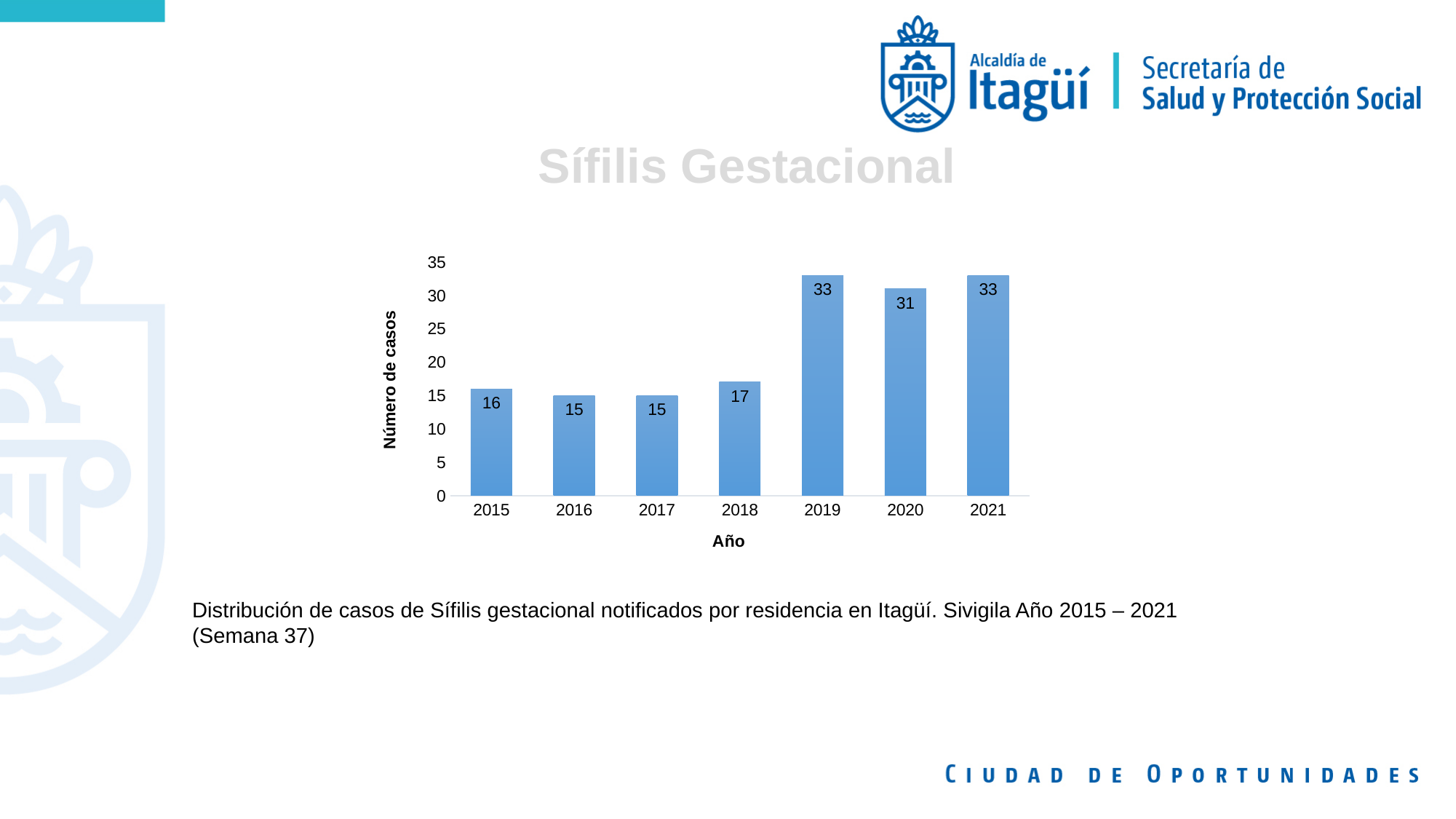
What is the difference in cases between 2021 and 2020? 2 Which year has more cases, 2015 or 2018? 2018 What kind of chart is shown on the slide? bar chart What is the label of the y axis? Número de casos Is the value for 2020 greater or less than 25? greater What is the number of cases for 2018? 17 How many years are shown on the x axis? 7 What is the difference in cases between 2019 and 2018? 16 What is the number of cases for 2019? 33 What is the number of cases for 2020? 31 What is the number of cases for 2016? 15 Which year has the lowest number of cases? 2016 and 2017